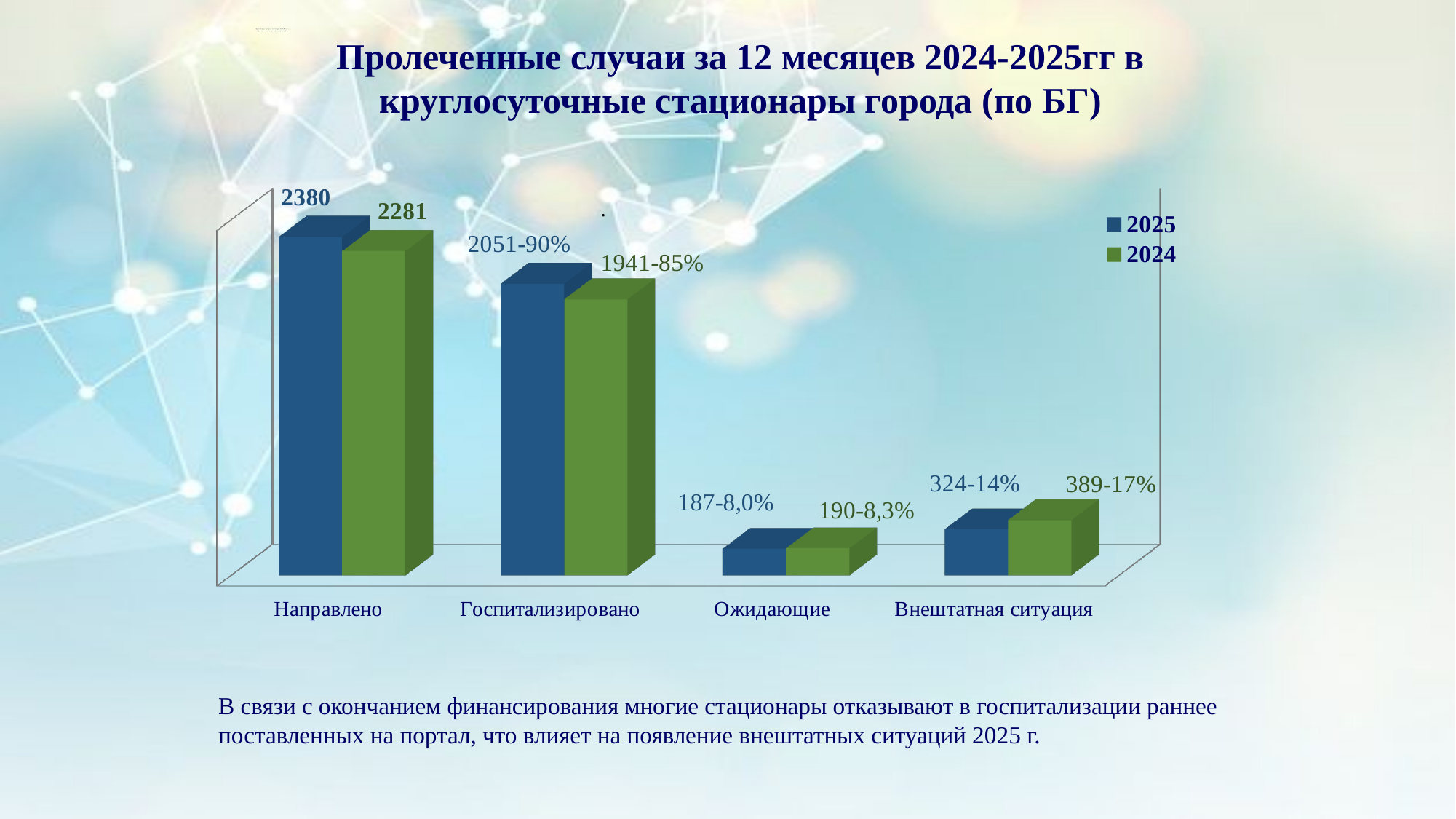
How many series does the legend list? 2 Which category has the lowest value in the 2024 series? Ожидающие What is the value for Направлено in the 2025 series? 2380 Which category has the highest value in the 2025 series? Направлено What label is shown for Внештатная ситуация in the 2024 series? 389-17% How many categories are shown on the x axis? 4 For Внештатная ситуация, which series has the larger value, 2025 or 2024? 2024 What is the difference between the 2025 and 2024 values for Направлено? 99 What label is shown for Ожидающие in the 2025 series? 187-8,0% What label is shown for Госпитализировано in the 2025 series? 2051-90% What is the value for Направлено in the 2024 series? 2281 What label is shown for Госпитализировано in the 2024 series? 1941-85%